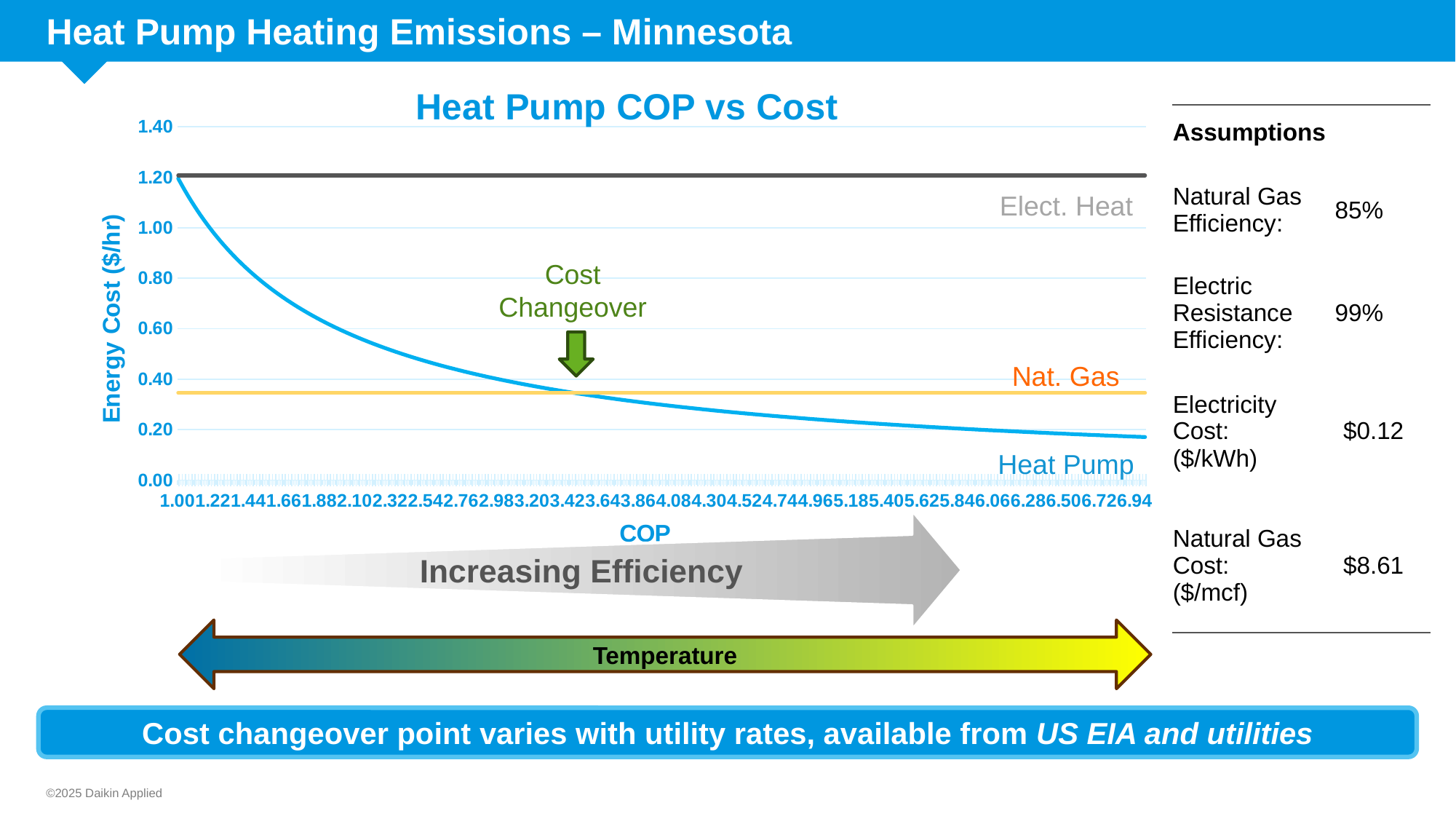
Is the Energy Cost of the Heat Pump line at a COP of 4.08 greater or less than 0.40? less What kind of chart is shown on the slide? line chart Is the Energy Cost of the Nat. Gas line greater or less than 0.40? less What is the label of the vertical axis of the chart? Energy Cost ($/hr) What is the title of the chart? Heat Pump COP vs Cost At a COP of 1.00, which is larger: the Heat Pump cost or the Nat. Gas cost? Heat Pump Does the Heat Pump line rise or fall as COP increases along the x axis? fall Which line has the highest Energy Cost across the chart? Elect. Heat Which line has the lowest Energy Cost at a COP of 6.94? Heat Pump How many lines (series) are plotted on the chart? 3